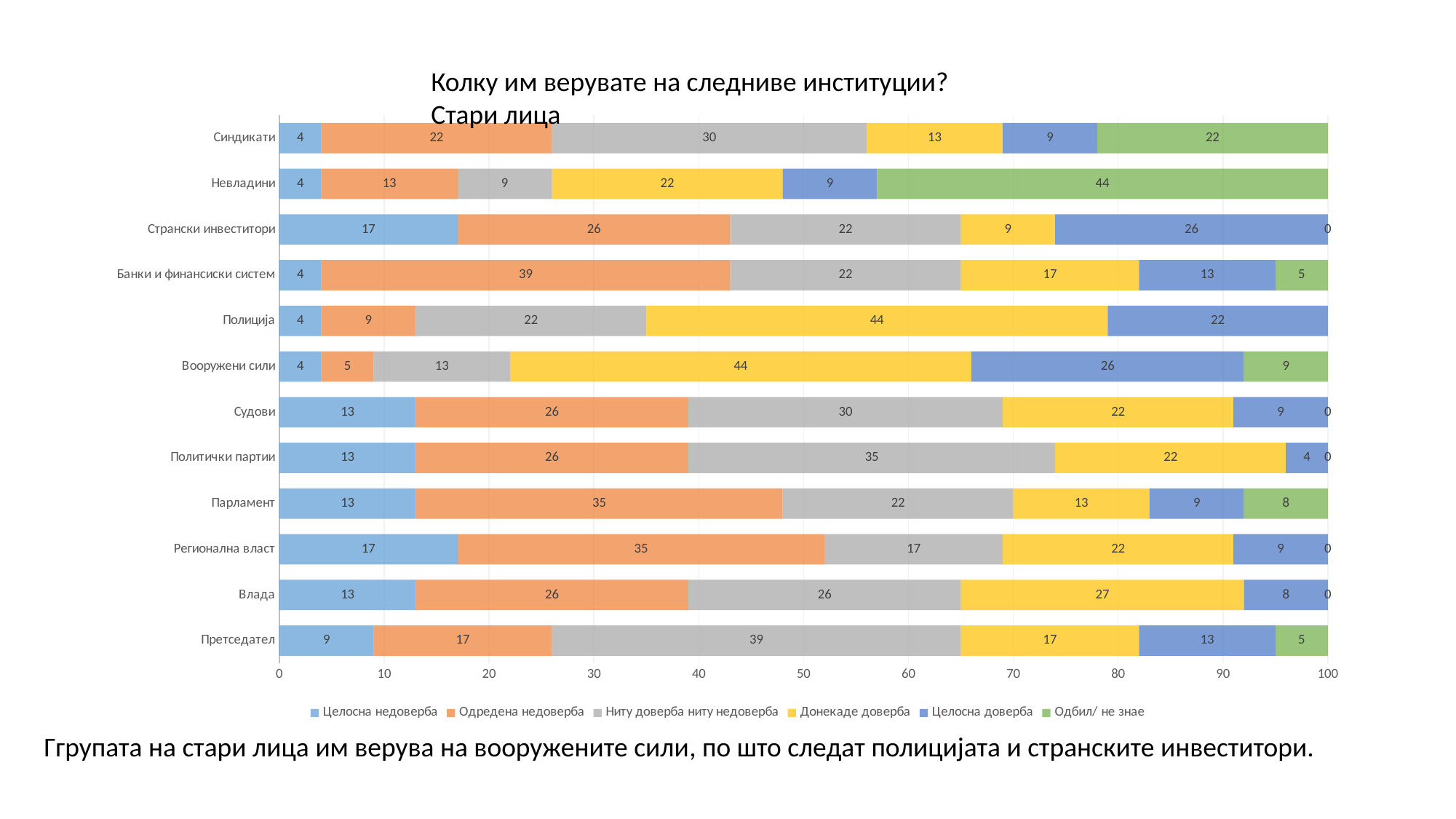
Which institution has the highest value for Ниту доверба ниту недоверба? Претседател What is the value of Одредена недоверба for Вооружени сили? 5 What is the title of the chart? Колку им верувате на следниве институции? Стари лица What is the value of Донекаде доверба for Полиција? 44 What is the difference between the Целосна доверба values for Полиција and Судови? 13 What kind of chart is shown on the slide? Stacked bar chart How many series does the legend list? 6 How many institutions (categories) are shown on the chart? 12 Which has a larger Одбил/ не знае value, Синдикати or Парламент? Синдикати What is the value of Одбил/ не знае for Невладини? 44 What is the value of Целосна недоверба for Регионална власт? 17 Which institution has the highest value for Одредена недоверба? Банки и финансиски систем